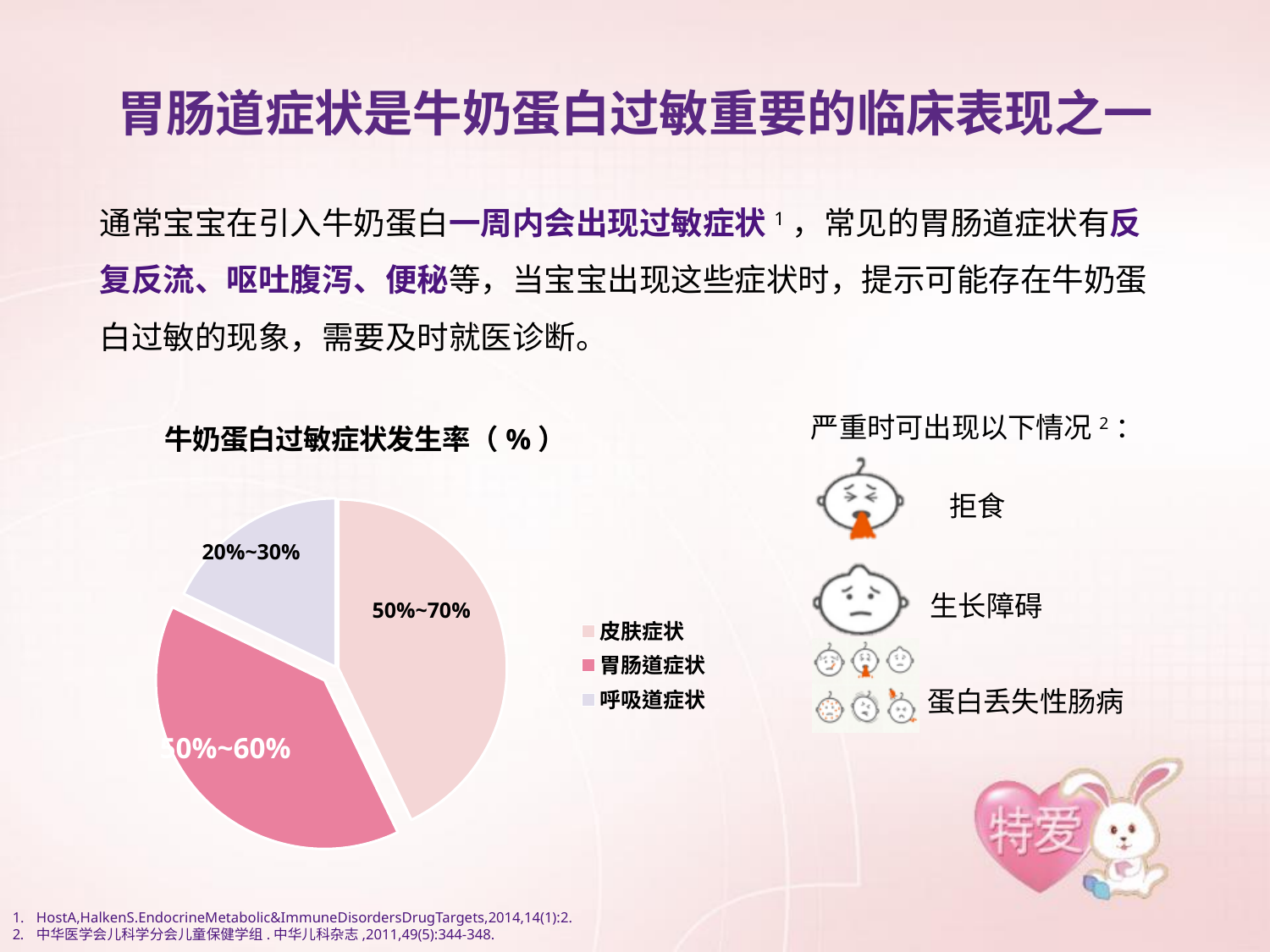
Which slice is larger in the pie chart, 胃肠道症状 or 呼吸道症状? 胃肠道症状 What value is labelled on the 呼吸道症状 slice of the pie chart? 20%~30% What kind of chart is shown on the slide? pie chart Which category has the largest slice in the pie chart? 皮肤症状 Which category has the smallest slice in the pie chart? 呼吸道症状 What value is labelled on the 胃肠道症状 slice of the pie chart? 50%~60% How many entries does the legend of the pie chart list? 3 What value is labelled on the 皮肤症状 slice of the pie chart? 50%~70% How many slices does the pie chart have? 3 What is the title of the pie chart? 牛奶蛋白过敏症状发生率（%） Which legend entry of the pie chart is shown in the darker pink colour? 胃肠道症状